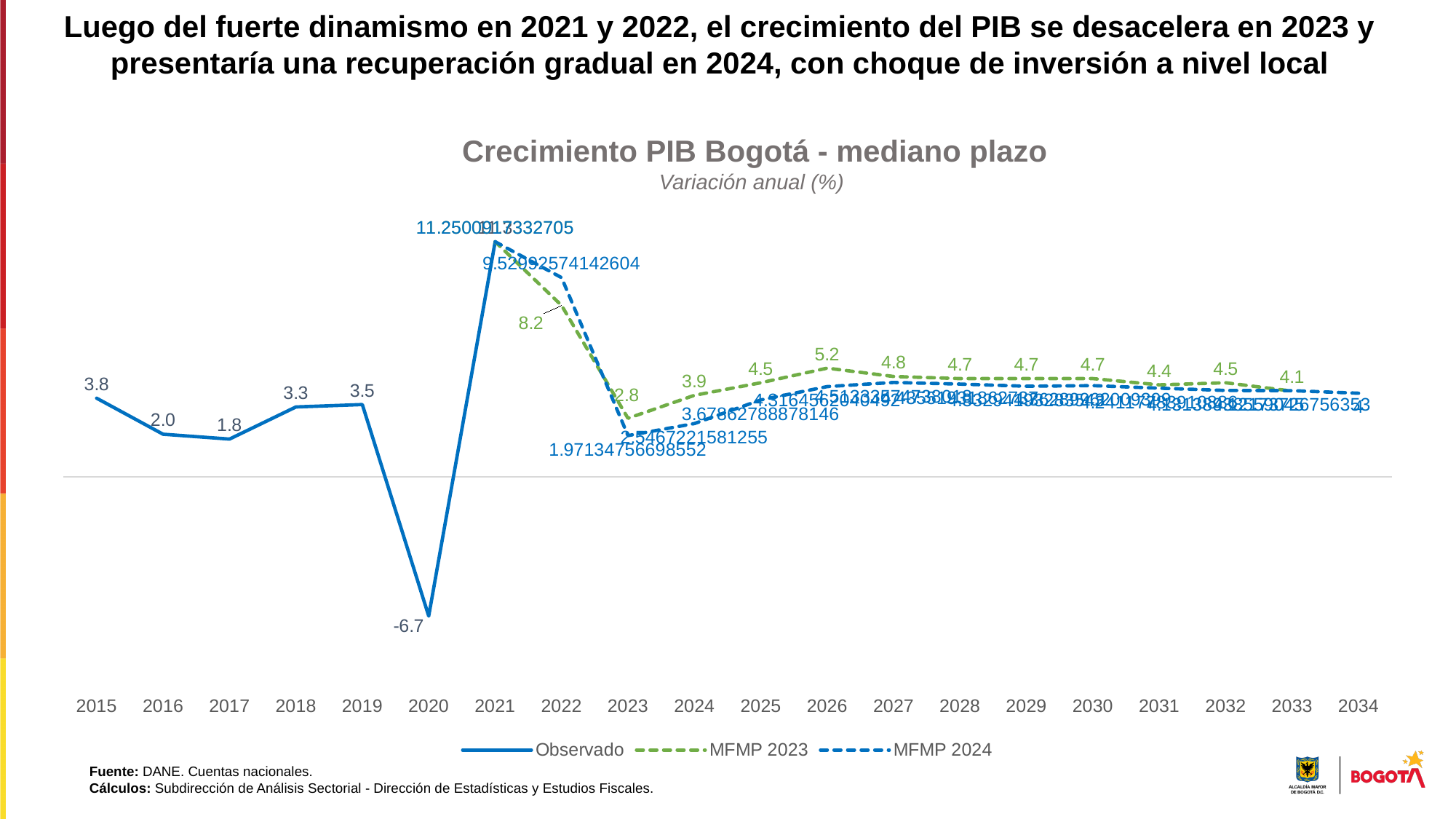
In which year does the Observado series reach its lowest value? 2020 What is the MFMP 2023 value for 2033? 4.1 What kind of chart is shown on the slide? Line chart How many series does the legend list? 3 What is the Observado value for 2020? -6.7 What is the Observado value for 2017? 1.8 In which year between 2023 and 2033 does the MFMP 2023 series reach its highest value? 2026 How many years are shown on the x axis? 20 Which year has the larger Observado value, 2016 or 2017? 2016 What is the Observado value for 2015? 3.8 What is the difference between the Observado values for 2019 and 2018? 0.2 What is the MFMP 2023 value for 2026? 5.2